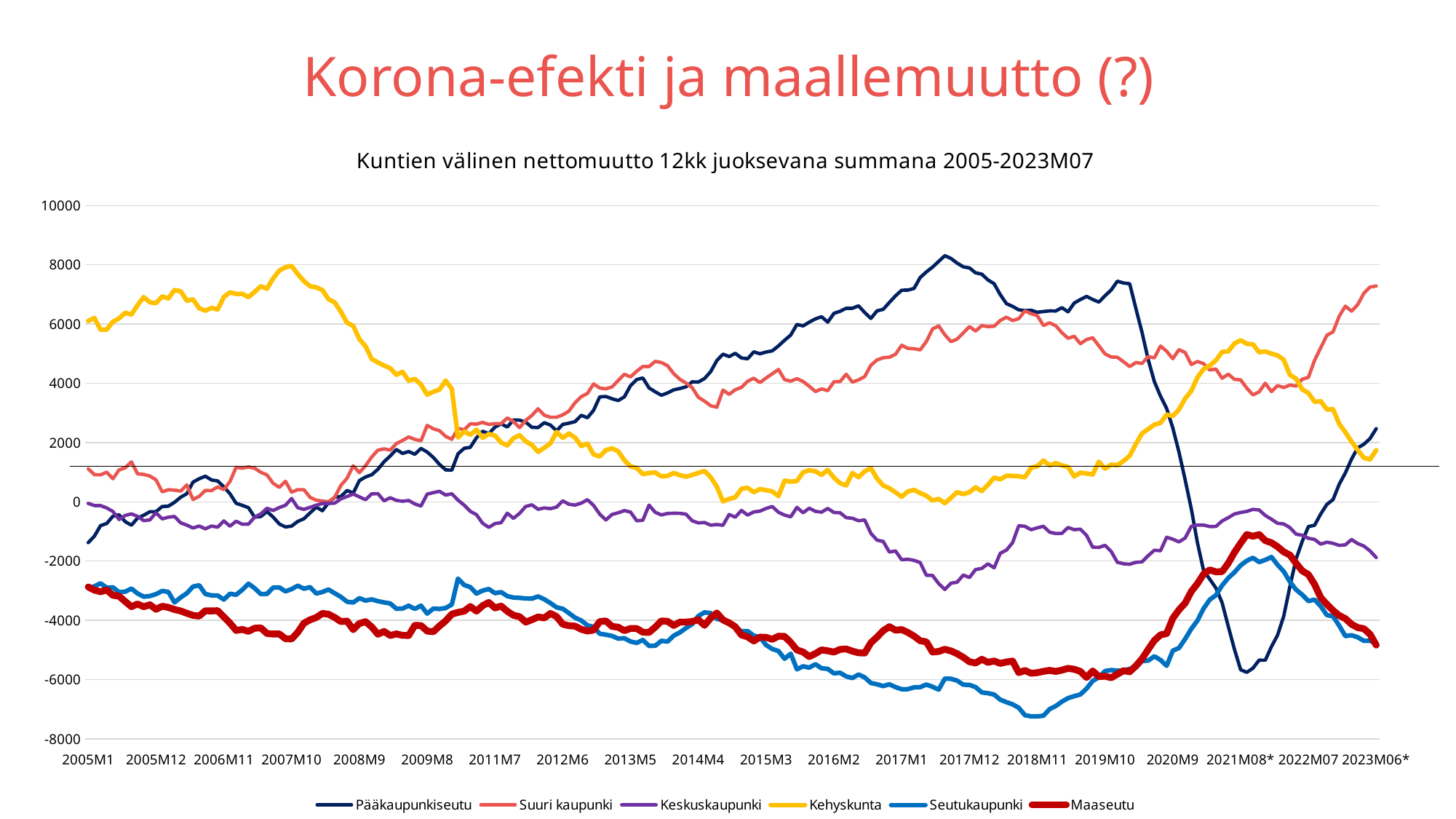
At 2023M06*, which is larger: the value for Suuri kaupunki or the value for Kehyskunta? Suuri kaupunki Does the Seutukaupunki series rise or fall between 2005M1 and 2018M11? fall How many series does the legend list? 6 What kind of chart is shown on the slide? line chart Is the value for Maaseutu at 2005M1 greater or less than -2000? less Is the value for Suuri kaupunki at 2023M06* greater or less than 6000? greater Which series has the highest value at 2005M1? Kehyskunta Which colour is used for the Kehyskunta series? yellow Is the value for Seutukaupunki at 2018M11 greater or less than -6000? less What is the title of the chart? Kuntien välinen nettomuutto 12kk juoksevana summana 2005-2023M07 Which series has the highest value at 2023M06*? Suuri kaupunki